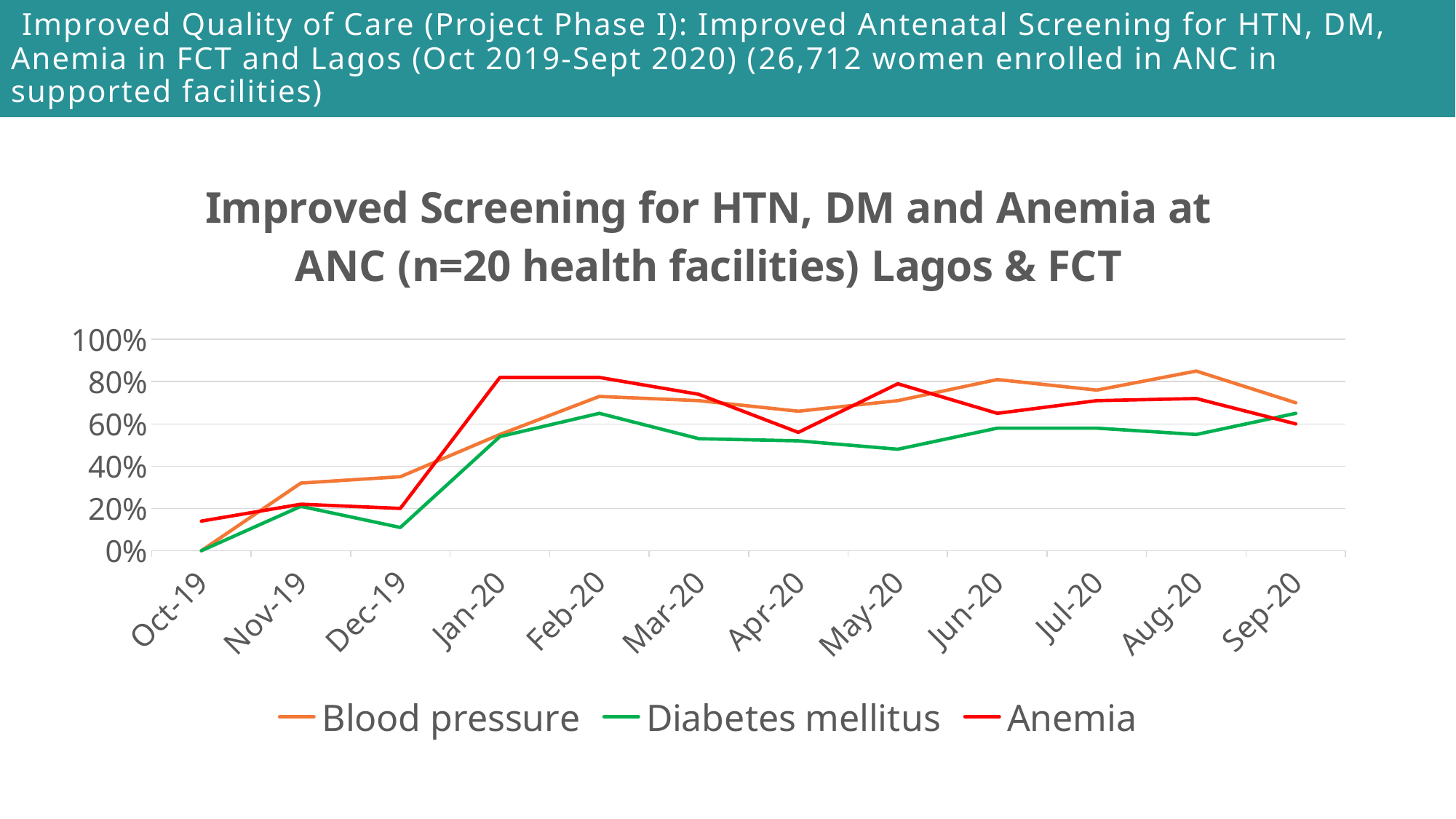
How many series does the legend list? 3 Is the Diabetes mellitus value for May-20 greater or less than 60%? less What kind of chart is shown on the slide? line chart What colour is the Anemia line in the legend? red Does the Blood pressure series rise or fall from Oct-19 to Jan-20? rise Is the Blood pressure value for Aug-20 greater or less than 80%? greater Is the Anemia value for Jan-20 greater or less than 60%? greater In Mar-20, which is larger: the Anemia value or the Diabetes mellitus value? Anemia What is the Diabetes mellitus value for Oct-19? 0% In which month is the Diabetes mellitus series at its lowest? Oct-19 In which month does the Blood pressure series reach its highest value? Aug-20 How many months are plotted along the x axis? 12